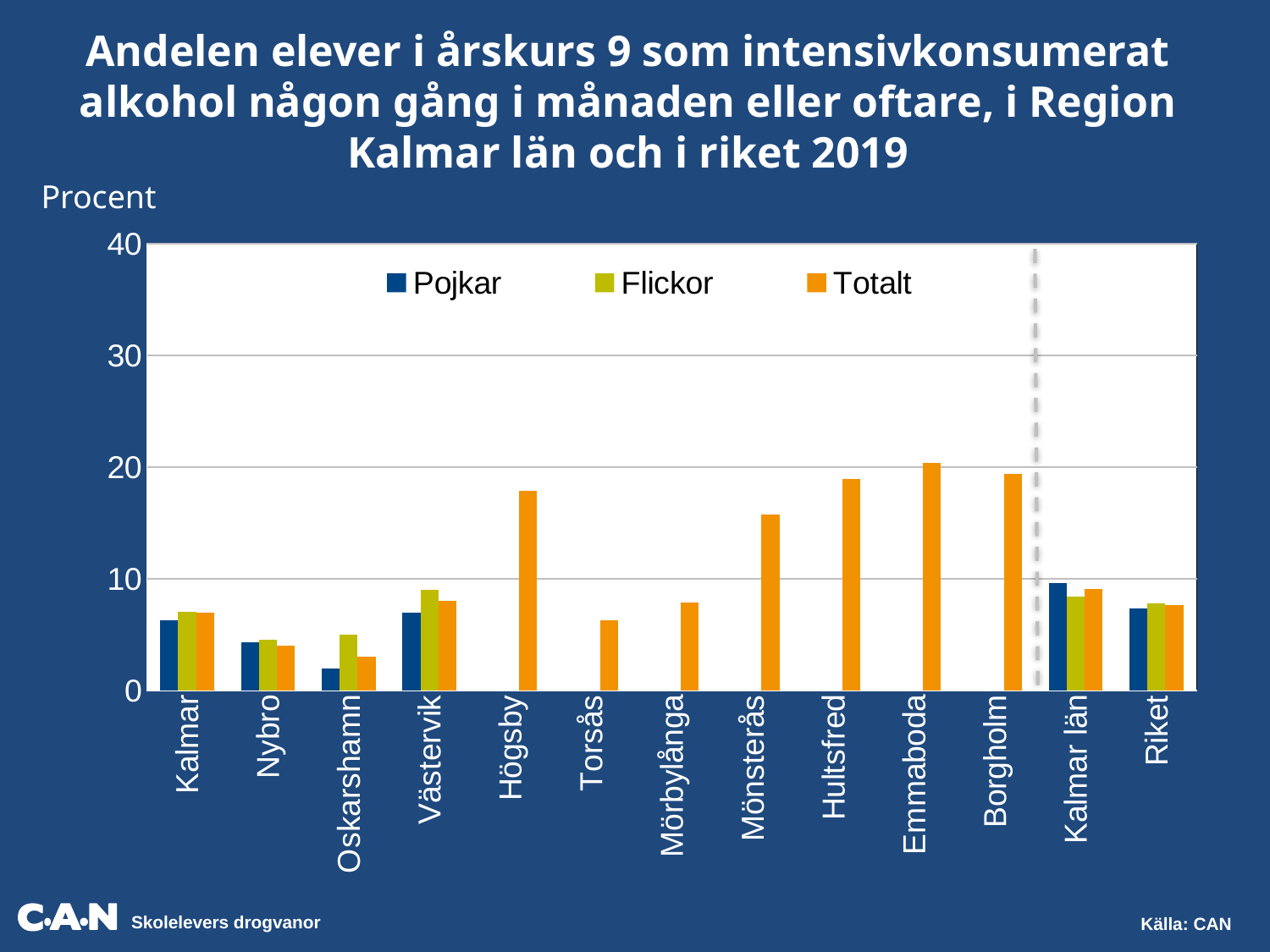
Which category has the lowest Totalt value? Oskarshamn What unit is shown on the y axis label? Procent How many categories are shown along the x axis? 13 Is the Totalt value for Högsby greater or less than 20? less For Västervik, which is larger: the Pojkar value or the Flickor value? Flickor For Kalmar län, which is larger: the Pojkar value or the Flickor value? Pojkar What kind of chart is shown on the slide? bar chart Is the Totalt value for Oskarshamn greater or less than 10? less Which category has the highest Totalt value? Emmaboda How many series does the legend list? 3 Is the Totalt value for Mönsterås greater or less than 10? greater